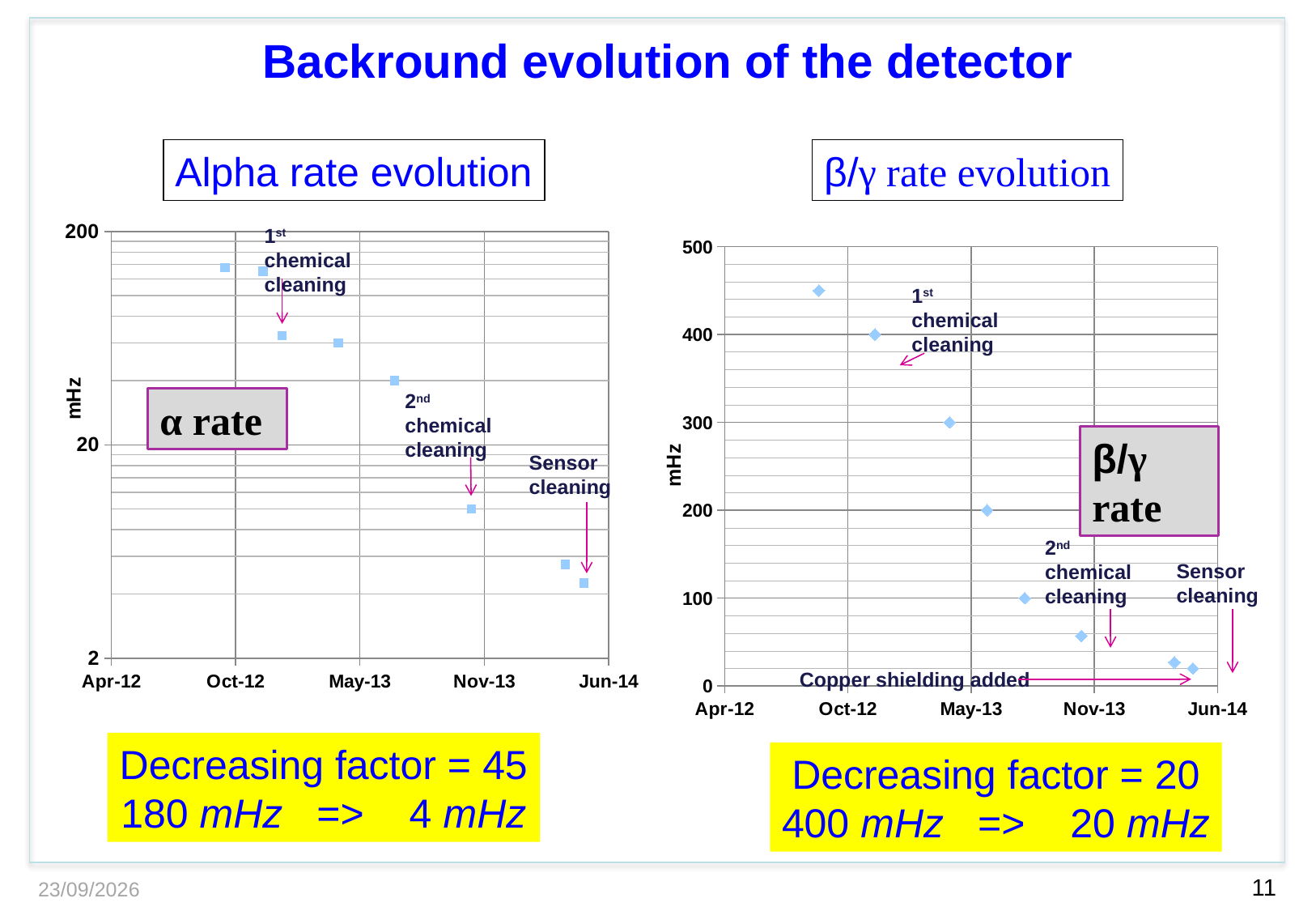
In the β/γ rate evolution chart, which is larger: the value of the earliest point or the value of the latest point? the earliest point In the β/γ rate evolution chart, do the values rise or fall over time along the x axis? fall What kind of chart is the β/γ rate evolution chart? scatter chart In the β/γ rate evolution chart, is the value of the latest point (near Jun-14) greater or less than 100? less What kind of chart is the Alpha rate evolution chart? scatter chart In the Alpha rate evolution chart, do the values rise or fall over time along the x axis? fall In the Alpha rate evolution chart, is the value of the latest point (near Jun-14) greater or less than 20? less In the β/γ rate evolution chart, is the value of the earliest point greater or less than 400? greater What unit is shown on the y axis of the Alpha rate evolution chart? mHz How many data points are plotted in the Alpha rate evolution chart? 8 How many data points are plotted in the β/γ rate evolution chart? 8